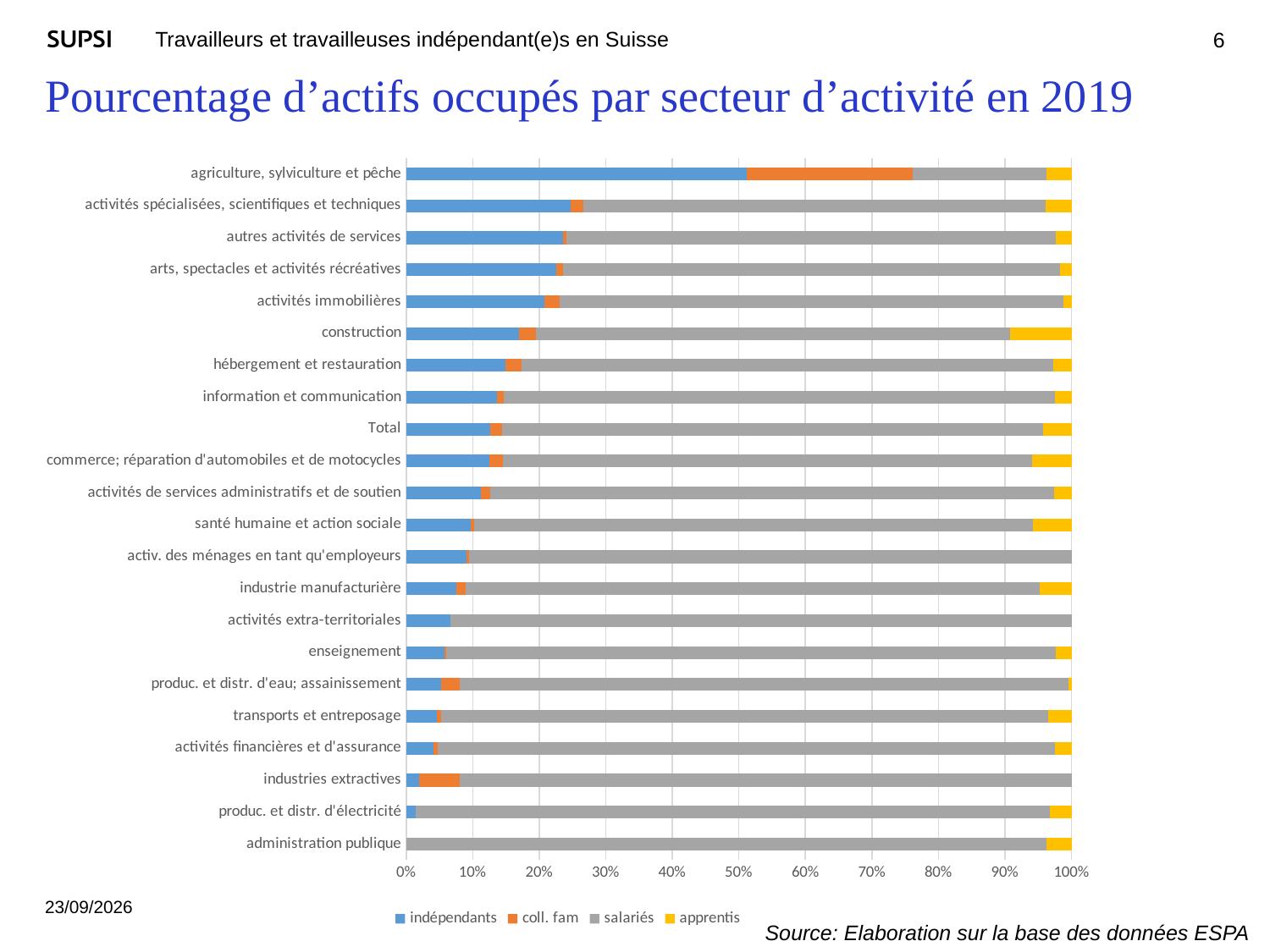
Which has a larger share of indépendants: agriculture, sylviculture et pêche or construction? agriculture, sylviculture et pêche How many series does the legend list? 4 Is the share of indépendants for activités spécialisées, scientifiques et techniques greater or less than 20%? greater What kind of chart is shown on the slide? stacked bar chart Which sector has the highest share of indépendants? agriculture, sylviculture et pêche Is the share of indépendants for agriculture, sylviculture et pêche greater or less than 40%? greater What is the title of the chart? Pourcentage d'actifs occupés par secteur d'activité en 2019 Which series is shown in orange in the legend? coll. fam Is the share of indépendants for construction greater or less than 20%? less Which sector has the lowest share of indépendants? administration publique How many sectors (categories) are plotted on the chart, including Total? 22 Which sector has the largest share of apprentis? construction